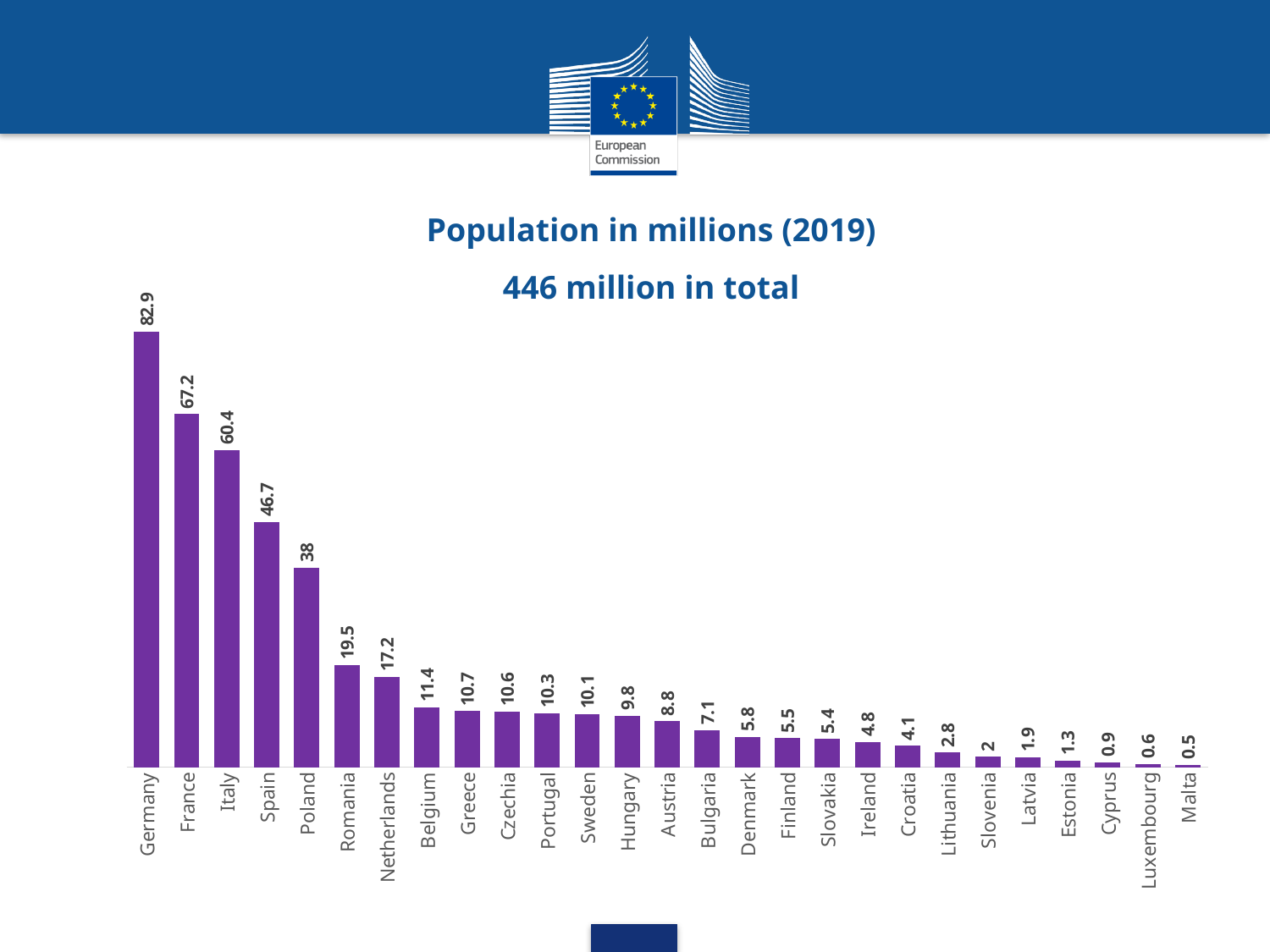
What is the difference in population (millions) between Spain and Poland? 8.7 What type of chart is shown on the slide? Bar chart What is the population in millions shown for Poland? 38 What is the difference in population (millions) between France and Italy? 6.8 Which has a larger population, Romania or Belgium? Romania What is the population in millions shown for Germany? 82.9 Which country has the highest population in the chart? Germany What is the title of the chart? Population in millions (2019) What is the population in millions shown for Luxembourg? 0.6 How many countries are shown in the chart? 27 What is the population in millions shown for Netherlands? 17.2 Which country has the lowest population in the chart? Malta